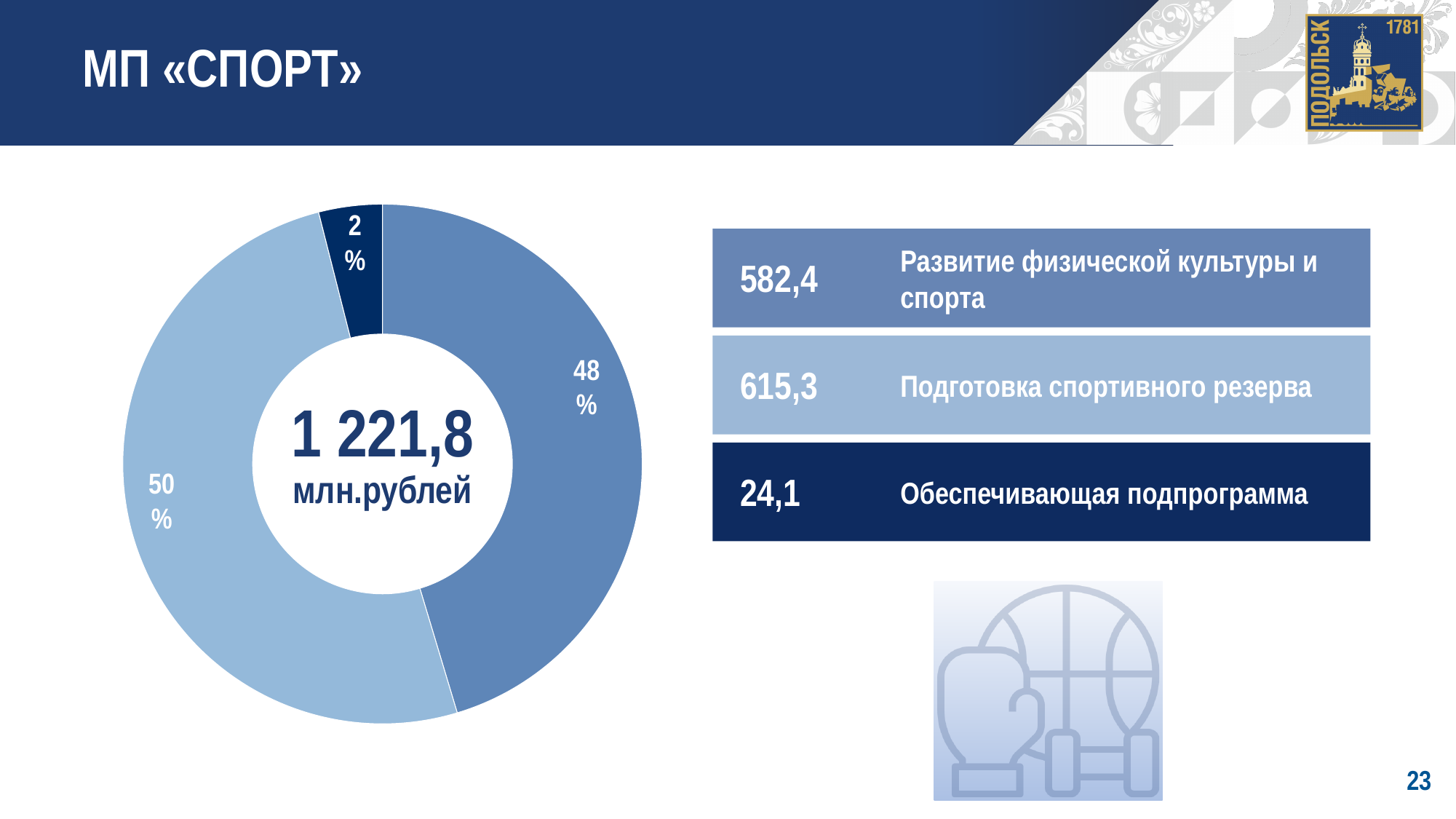
What is the value shown for «Развитие физической культуры и спорта»? 582,4 What total amount is shown in the centre of the donut chart? 1 221,8 млн.рублей What is the value shown for «Подготовка спортивного резерва»? 615,3 What share of the donut chart does «Развитие физической культуры и спорта» take? 48% Which subprogram has the largest share of the donut chart? Подготовка спортивного резерва What is the difference between the values for «Подготовка спортивного резерва» and «Развитие физической культуры и спорта»? 32,9 What kind of chart is shown on the slide? Pie (donut) chart What share of the donut chart does «Обеспечивающая подпрограмма» take? 2% Which subprogram has the smallest share of the donut chart? Обеспечивающая подпрограмма How many slices does the donut chart have? 3 What is the value shown for «Обеспечивающая подпрограмма»? 24,1 What share of the donut chart does «Подготовка спортивного резерва» take? 50%